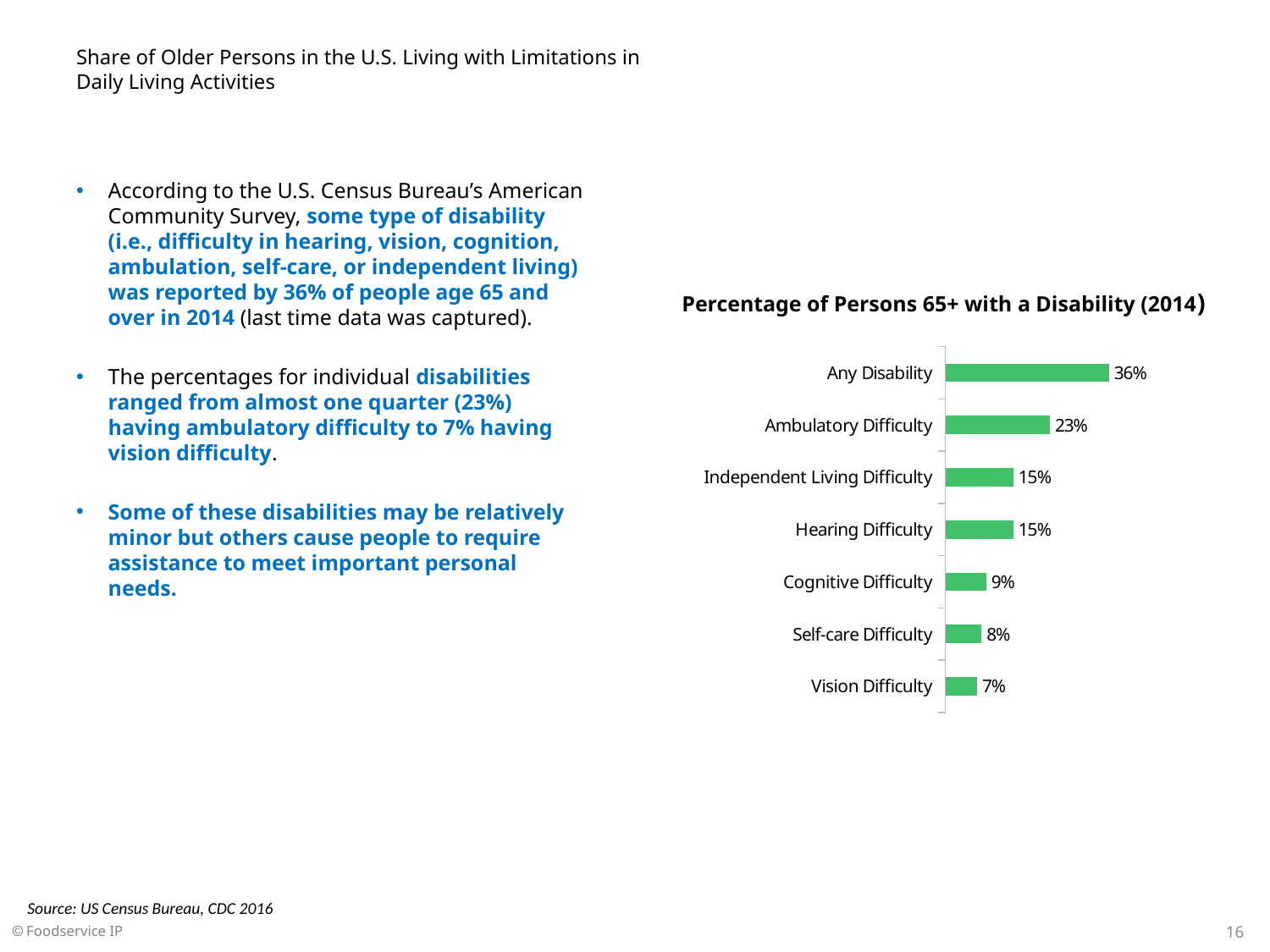
What is the value for Any Disability? 36% Which category has the lowest value? Vision Difficulty What is the title of the chart? Percentage of Persons 65+ with a Disability (2014) What is the value for Cognitive Difficulty? 9% What kind of chart is shown on the slide? Bar chart Which category has the highest value? Any Disability What is the difference between the values for Any Disability and Ambulatory Difficulty? 13% What is the difference between the values for Hearing Difficulty and Vision Difficulty? 8% What is the value for Self-care Difficulty? 8% What is the value for Ambulatory Difficulty? 23% How many categories are shown in the chart? 7 Which is larger, the value for Independent Living Difficulty or the value for Cognitive Difficulty? Independent Living Difficulty